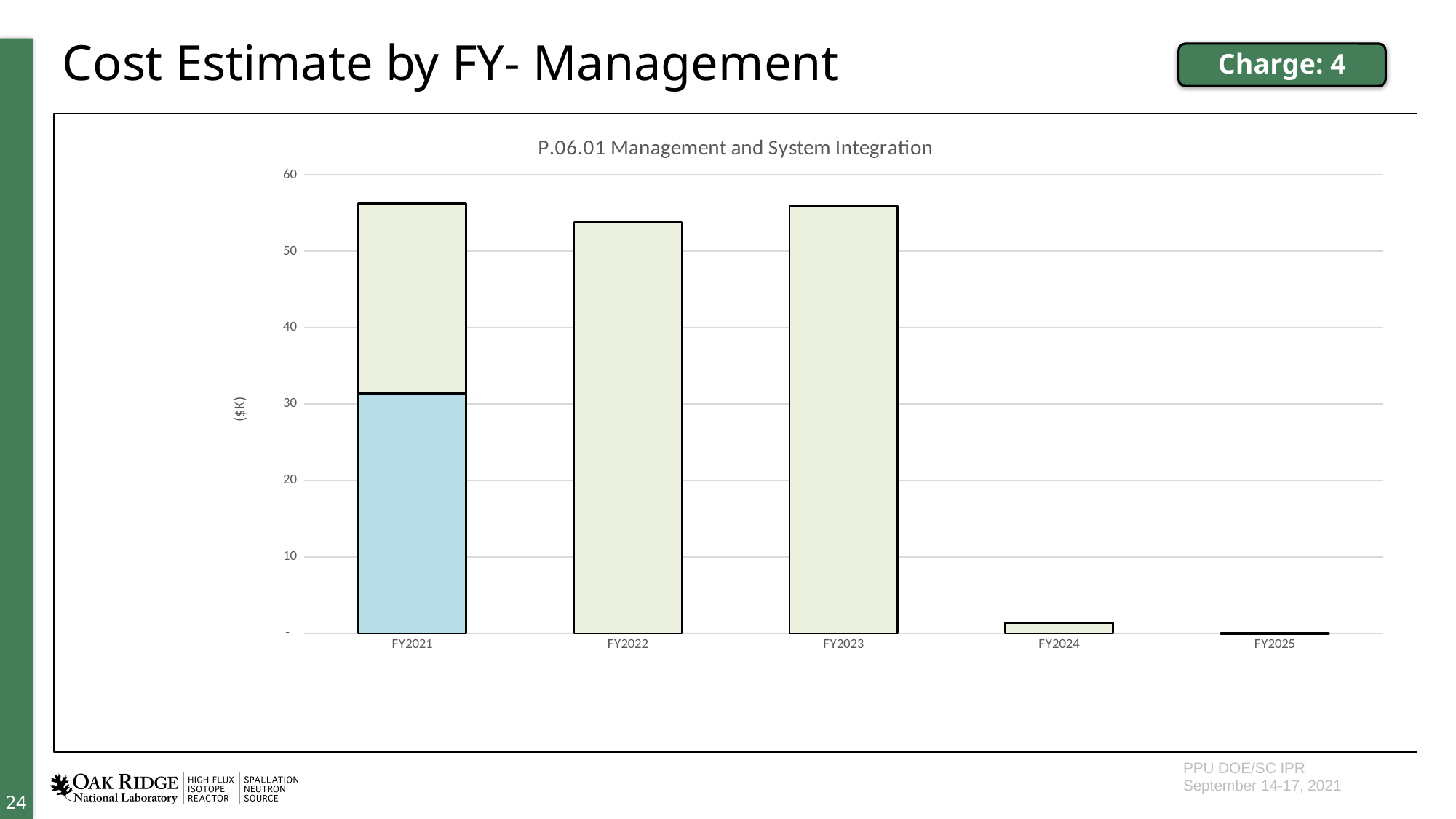
What is the title of the chart? P.06.01 Management and System Integration Do the values rise or fall from FY2023 to FY2025? fall Which fiscal year has the lowest value in the chart? FY2025 Is the value for FY2024 greater or less than 10? less What is the label on the y axis of the chart? ($K) What kind of chart is shown on the slide? bar chart Is the value for FY2022 greater or less than 50? greater Is the blue segment of the FY2021 bar greater or less than 40? less Which is larger, the value for FY2023 or the value for FY2024? FY2023 How many fiscal years are shown on the x axis of the chart? 5